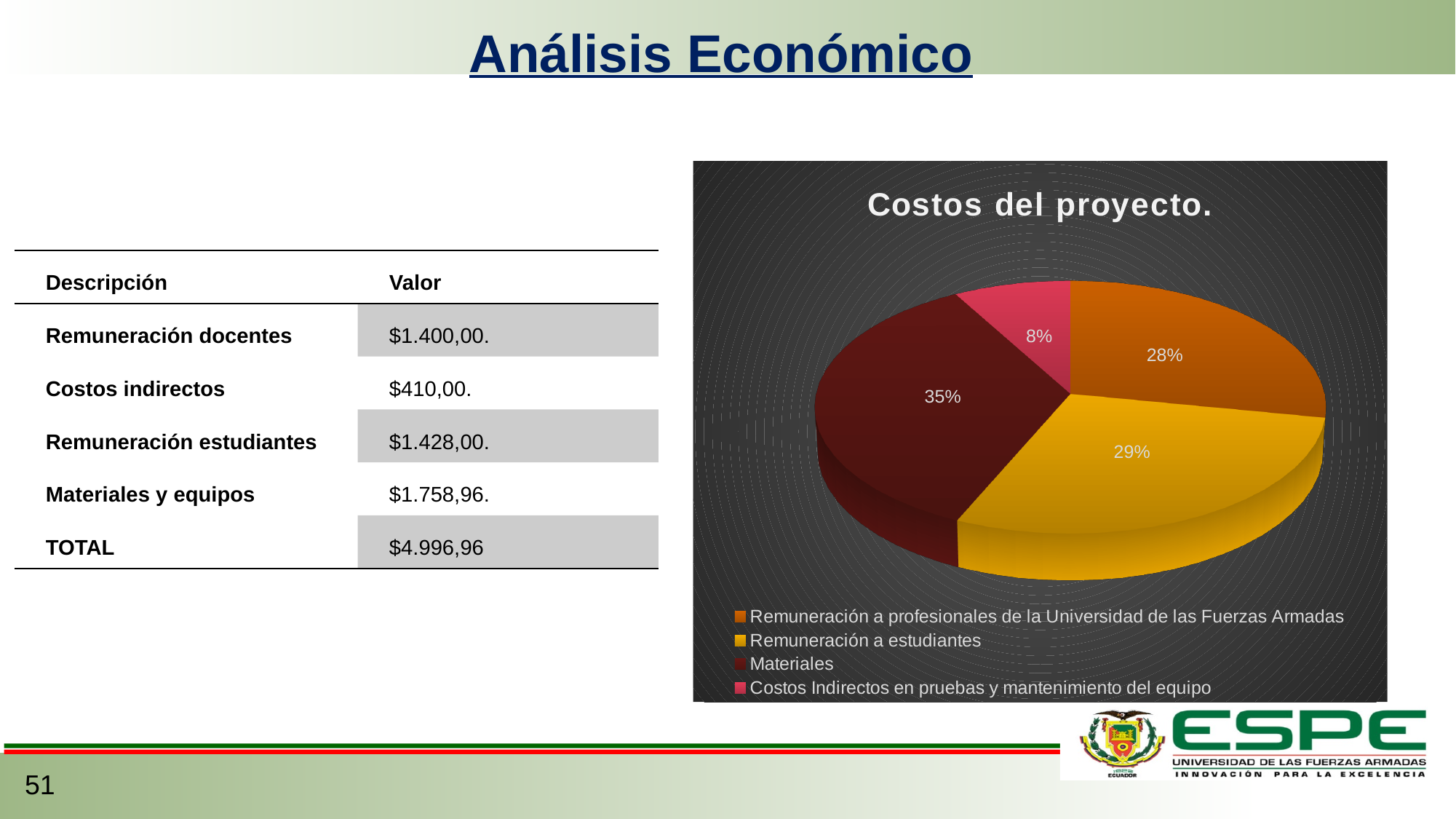
What is the difference in percentage points between the Materiales slice and the Costos Indirectos slice? 27 What percentage is shown for Remuneración a estudiantes? 29% Which category has the largest slice of the pie? Materiales How many entries does the legend list? 4 What is the title of the chart? Costos del proyecto. What percentage of the pie does the Materiales slice represent? 35% What percentage is shown for Costos Indirectos en pruebas y mantenimiento del equipo? 8% How many slices does the pie chart have? 4 What percentage is shown for Remuneración a profesionales de la Universidad de las Fuerzas Armadas? 28% Which is larger, the Remuneración a estudiantes slice or the Costos Indirectos slice? Remuneración a estudiantes What kind of chart is shown on the slide? pie chart Which category has the smallest slice of the pie? Costos Indirectos en pruebas y mantenimiento del equipo